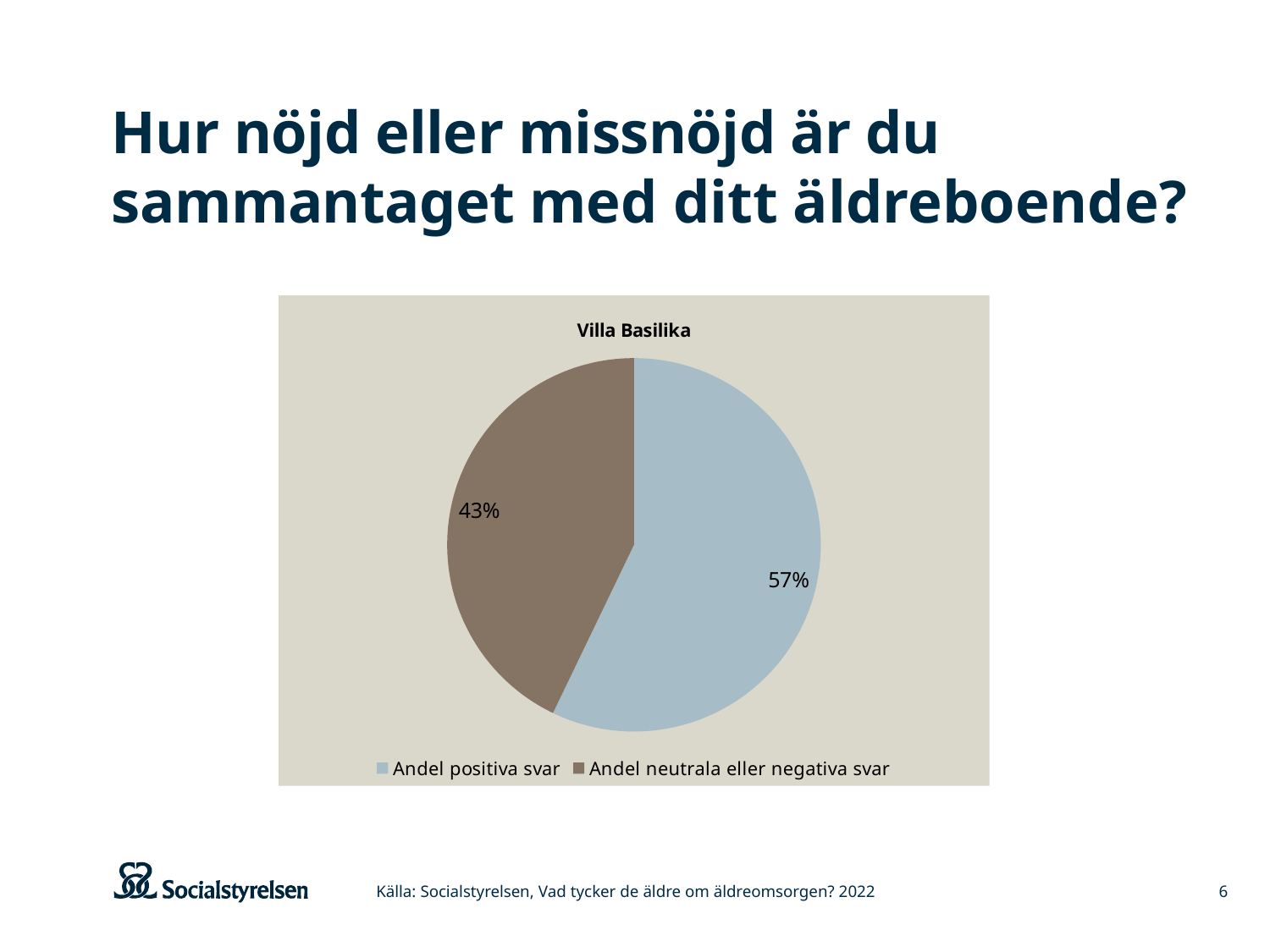
How many entries does the legend list? 2 Which slice is the smallest? Andel neutrala eller negativa svar Is the share for 'Andel positiva svar' greater or less than 50%? greater What is the chart's title? Villa Basilika What share of the pie is 'Andel positiva svar'? 57% What is the difference in percentage points between 'Andel positiva svar' and 'Andel neutrala eller negativa svar'? 14 How many slices does the pie chart have? 2 What colour is the 'Andel positiva svar' slice? light blue What kind of chart is shown on the slide? pie chart Which slice is the largest? Andel positiva svar Which is larger, 'Andel positiva svar' or 'Andel neutrala eller negativa svar'? Andel positiva svar What share of the pie is 'Andel neutrala eller negativa svar'? 43%